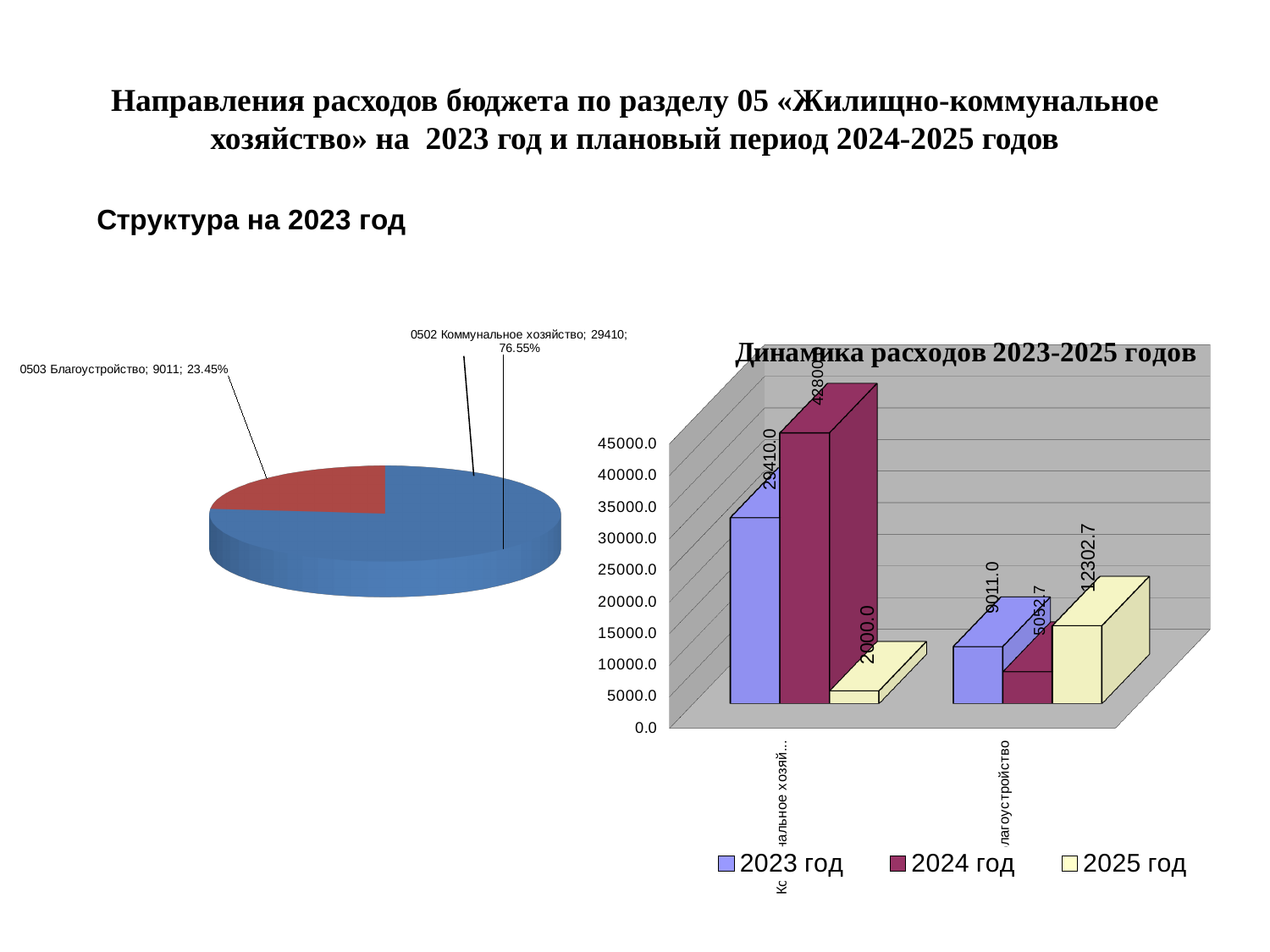
In the pie chart "Структура на 2023 год", what is the value for 0503 Благоустройство? 9011 In the chart "Динамика расходов 2023-2025 годов", what is the 2025 год value for Коммунальное хозяйство? 2000.0 In the chart "Динамика расходов 2023-2025 годов", which year has the highest value for Благоустройство? 2025 год What kind of chart is "Динамика расходов 2023-2025 годов"? bar chart In the pie chart "Структура на 2023 год", what share does 0502 Коммунальное хозяйство have? 76.55% In the chart "Динамика расходов 2023-2025 годов", what is the 2024 год value for Благоустройство? 5052.7 In the chart "Динамика расходов 2023-2025 годов", what is the difference between the 2025 год and 2024 год values for Благоустройство? 7250.0 What kind of chart is the one on the left of the slide, titled "Структура на 2023 год"? pie chart In the chart "Динамика расходов 2023-2025 годов", what is the 2025 год value for Благоустройство? 12302.7 In the pie chart "Структура на 2023 год", which slice is larger, 0502 Коммунальное хозяйство or 0503 Благоустройство? 0502 Коммунальное хозяйство In the chart "Динамика расходов 2023-2025 годов", how many series does the legend list? 3 In the pie chart "Структура на 2023 год", how many slices are there? 2